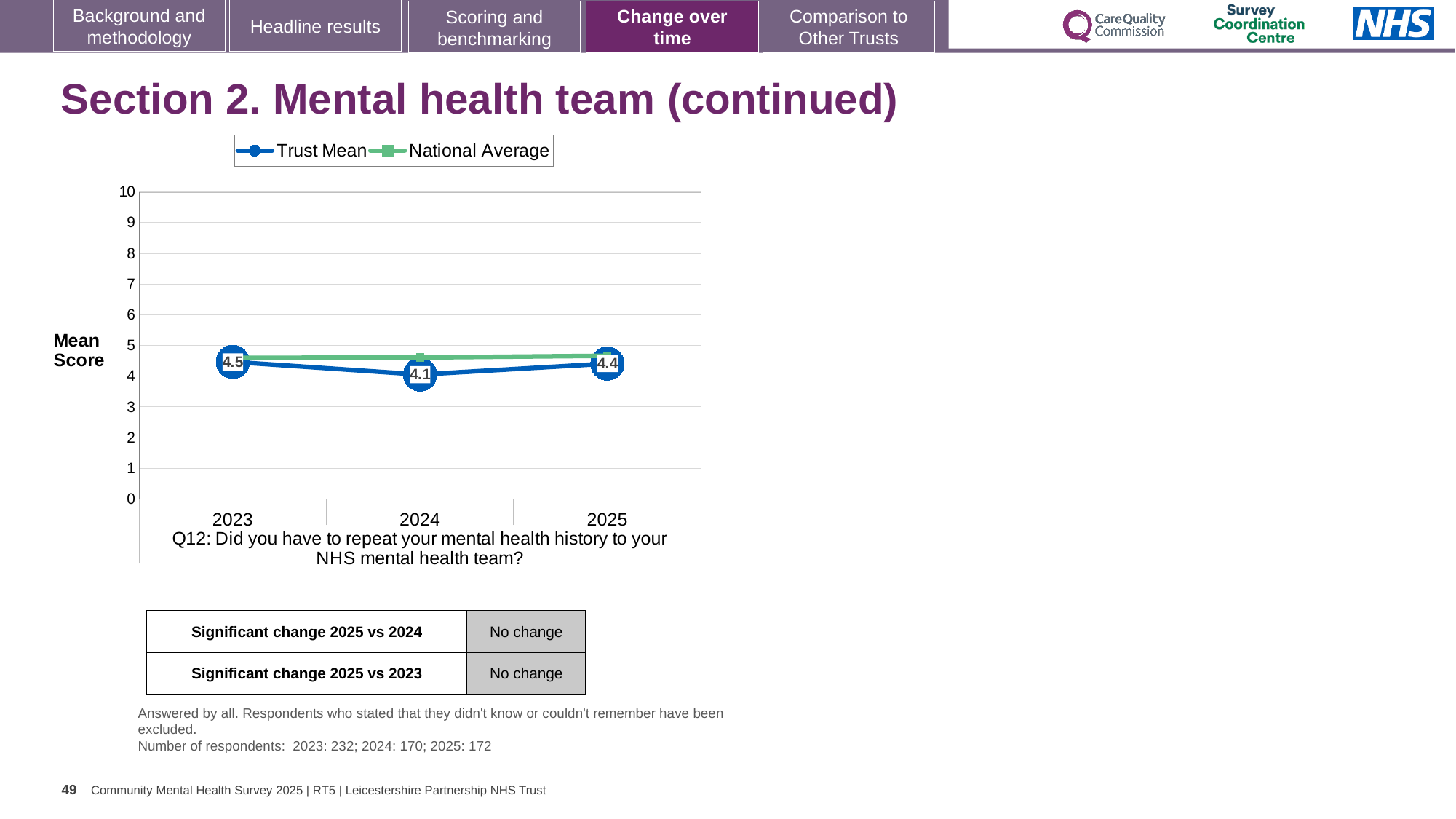
Is the National Average value for 2024 greater or less than 4? greater Does the Trust Mean rise or fall from 2023 to 2024? Fall What is the Trust Mean score for 2025? 4.4 How many series does the legend list? 2 In which year is the Trust Mean lowest? 2024 What kind of chart is shown? Line chart What is the difference between the Trust Mean in 2023 and in 2024? 0.4 What is the Trust Mean score for 2024? 4.1 In which year is the Trust Mean highest? 2023 What is the Trust Mean score for 2023? 4.5 How many years are shown on the x axis? 3 Is the Trust Mean higher in 2025 or in 2024? 2025